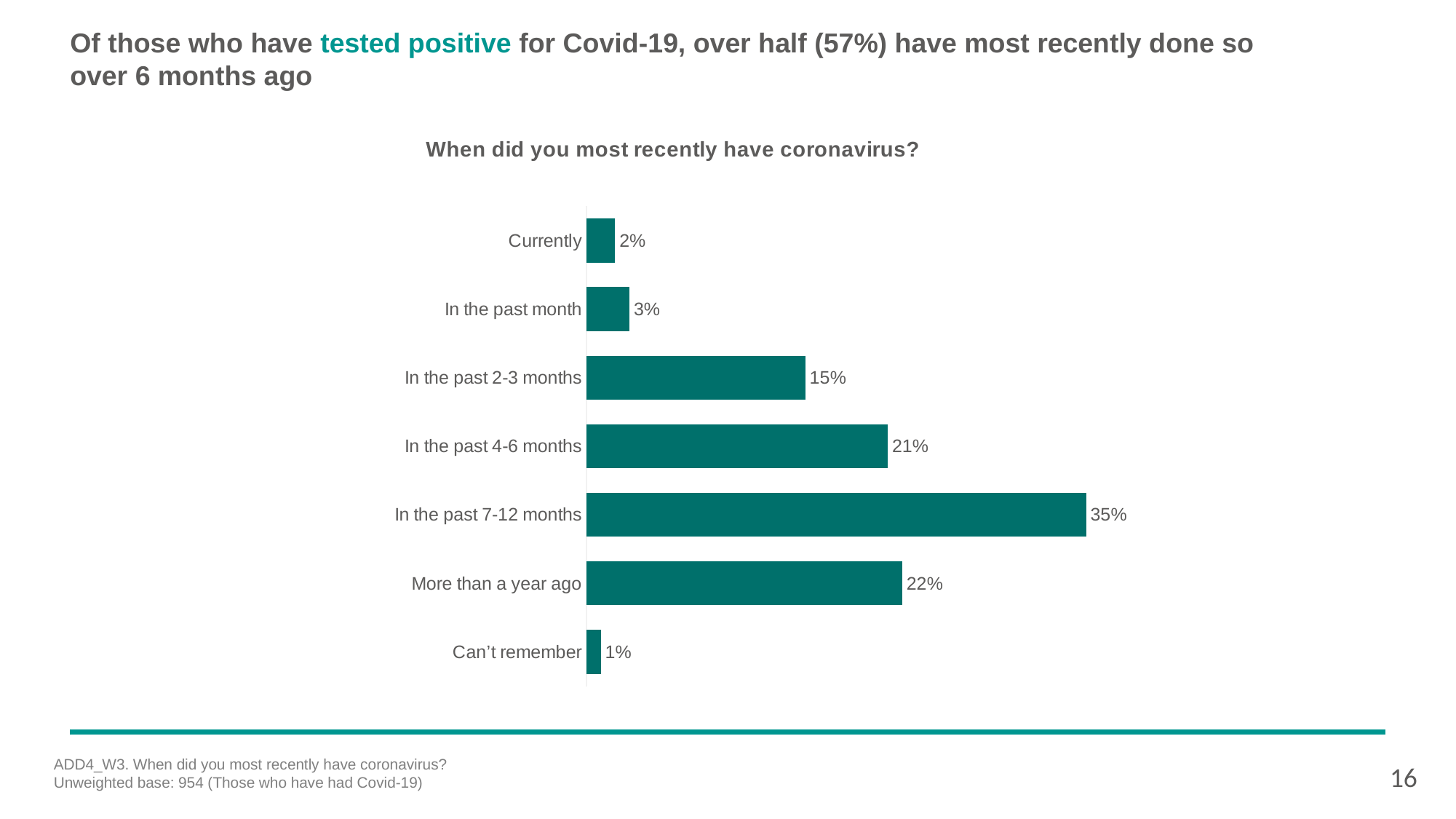
What is the value for 'More than a year ago'? 22% How many categories are shown in the chart? 7 What is the combined value of 'In the past 7-12 months' and 'More than a year ago'? 57% Which category has the highest value? In the past 7-12 months What percentage said 'Currently'? 2% What kind of chart is shown on the slide? Bar chart What is the value for 'In the past 2-3 months'? 15% What percentage of respondents said they most recently had coronavirus in the past 7-12 months? 35% Which category has the lowest value? Can't remember What is the difference between 'In the past 7-12 months' and 'In the past 4-6 months'? 14 percentage points What is the title of the chart? When did you most recently have coronavirus? Which is larger: 'More than a year ago' or 'In the past 4-6 months'? More than a year ago